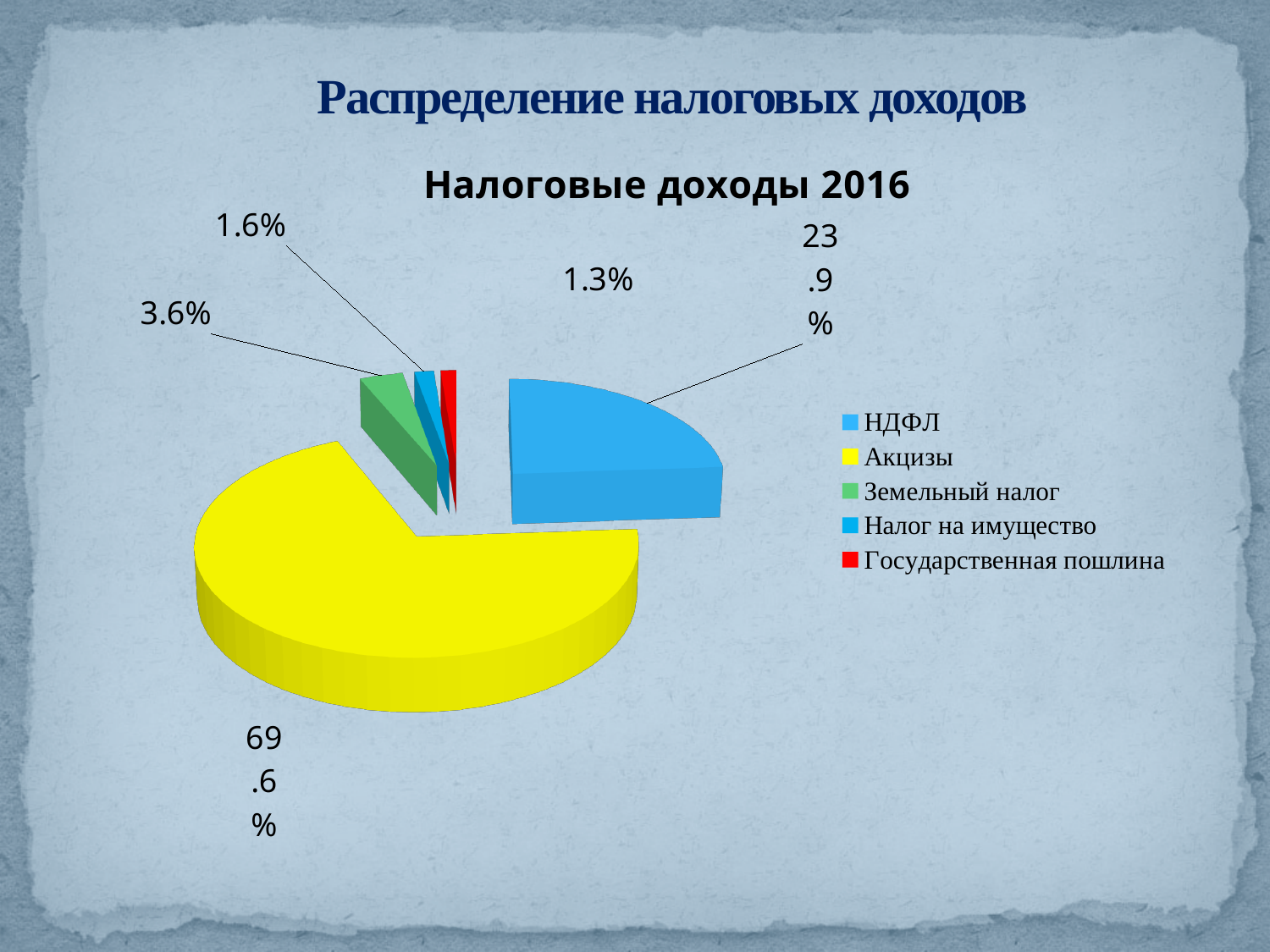
How many categories does the legend list? 5 What share of the pie does Государственная пошлина have? 1.3% What share of the pie does Налог на имущество have? 1.6% What is the difference between the shares of Акцизы and НДФЛ? 45.7% What kind of chart is shown on the slide? pie chart What share of the pie does Акцизы have? 69.6% What is the title of the chart? Налоговые доходы 2016 Which category has the smallest share of the pie? Государственная пошлина Which colour represents Земельный налог in the chart? green Which category has the largest share of the pie? Акцизы